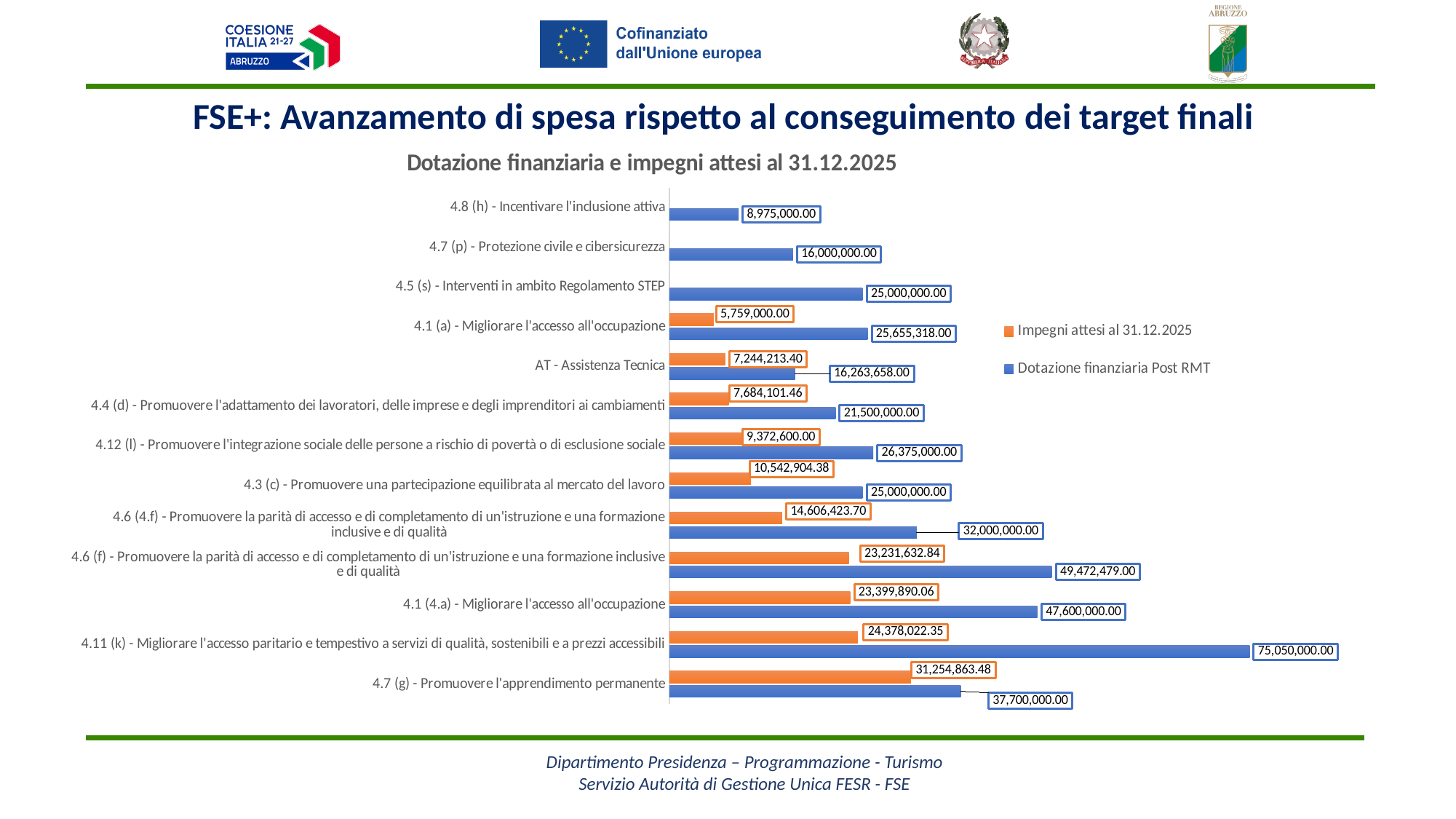
How many series does the legend list? 2 What is the Impegni attesi al 31.12.2025 value for 4.7 (g) - Promuovere l'apprendimento permanente? 31,254,863.48 Which category has the lowest Dotazione finanziaria Post RMT? 4.8 (h) - Incentivare l'inclusione attiva What is the Dotazione finanziaria Post RMT value for 4.11 (k) - Migliorare l'accesso paritario e tempestivo a servizi di qualità, sostenibili e a prezzi accessibili? 75,050,000.00 What is the difference between the Dotazione finanziaria Post RMT and the Impegni attesi al 31.12.2025 for 4.7 (g) - Promuovere l'apprendimento permanente? 6,445,136.52 Which has the larger Dotazione finanziaria Post RMT: 4.6 (f) - Promuovere la parità di accesso e di completamento di un'istruzione e una formazione inclusive e di qualità or 4.1 (4.a) - Migliorare l'accesso all'occupazione? 4.6 (f) - Promuovere la parità di accesso e di completamento di un'istruzione e una formazione inclusive e di qualità What is the title of the chart? Dotazione finanziaria e impegni attesi al 31.12.2025 Which category has the highest Dotazione finanziaria Post RMT? 4.11 (k) - Migliorare l'accesso paritario e tempestivo a servizi di qualità, sostenibili e a prezzi accessibili How many categories are shown on the chart? 13 What kind of chart is shown on the slide? Bar chart What is the Dotazione finanziaria Post RMT value for AT - Assistenza Tecnica? 16,263,658.00 Which category has the highest Impegni attesi al 31.12.2025? 4.7 (g) - Promuovere l'apprendimento permanente